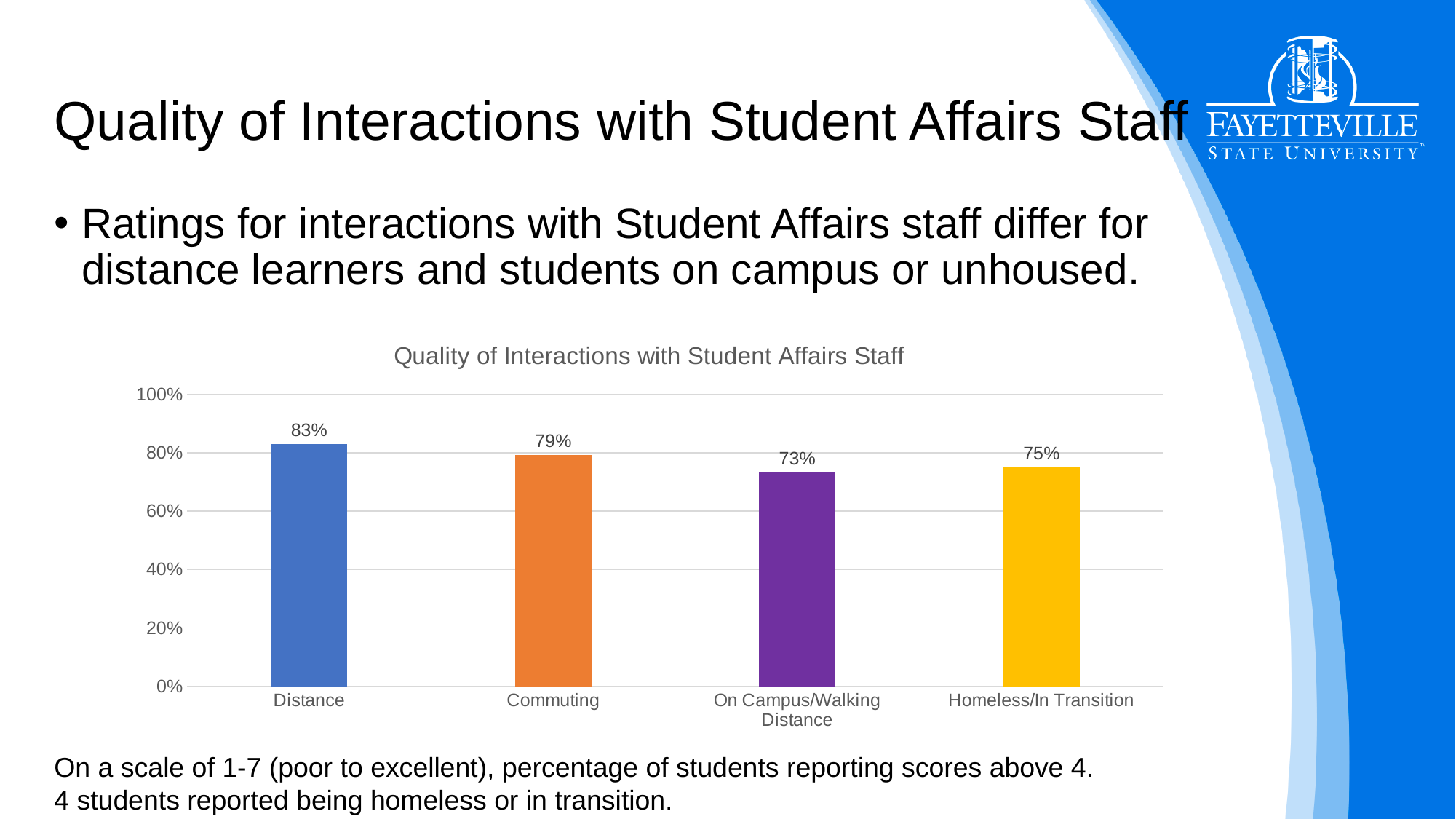
What is the value for Commuting? 79% Is the value for Commuting greater or less than 60%? greater Which is larger, the value for Commuting or the value for Homeless/In Transition? Commuting How many categories are shown on the x axis? 4 What is the value for Distance? 83% What kind of chart is shown on the slide? bar chart Which category has the highest value? Distance What is the difference between the values for Distance and On Campus/Walking Distance? 10% What is the title of the chart? Quality of Interactions with Student Affairs Staff What is the value for Homeless/In Transition? 75% What is the value for On Campus/Walking Distance? 73% Which category has the lowest value? On Campus/Walking Distance